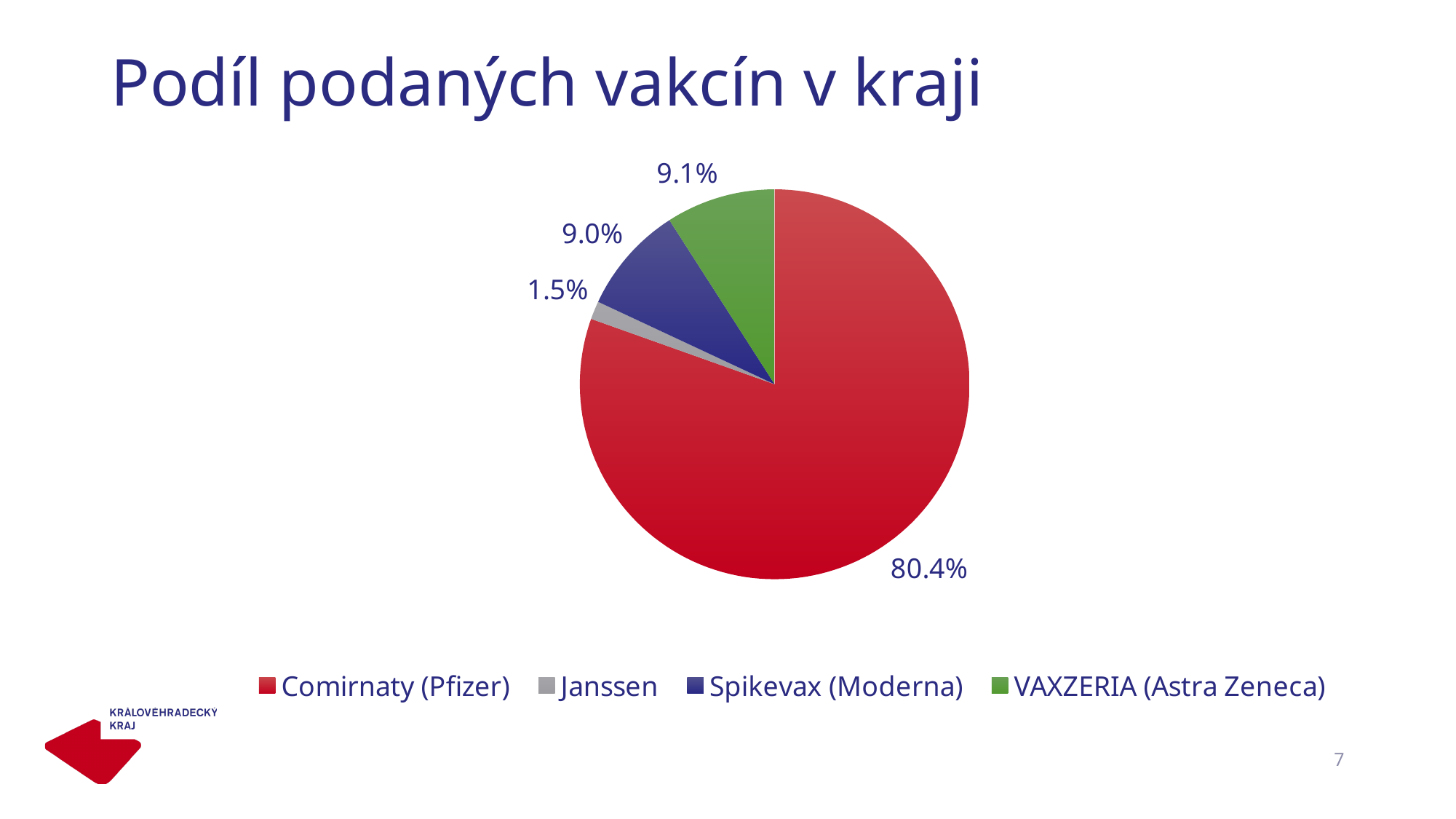
What share of the pie does Spikevax (Moderna) have? 9.0% What share of the pie does Janssen have? 1.5% How many slices does the pie chart have? 4 What share of the pie does Comirnaty (Pfizer) have? 80.4% What is the title of the slide containing the pie chart? Podíl podaných vakcín v kraji Which vaccine has the largest share of the pie? Comirnaty (Pfizer) What is the difference in percentage points between the shares of Comirnaty (Pfizer) and Janssen? 78.9 What share of the pie does VAXZERIA (Astra Zeneca) have? 9.1% What is the difference in percentage points between the shares of VAXZERIA (Astra Zeneca) and Spikevax (Moderna)? 0.1 What type of chart is shown on the slide? pie chart Which has a larger share, Spikevax (Moderna) or Janssen? Spikevax (Moderna) Which vaccine has the smallest share of the pie? Janssen